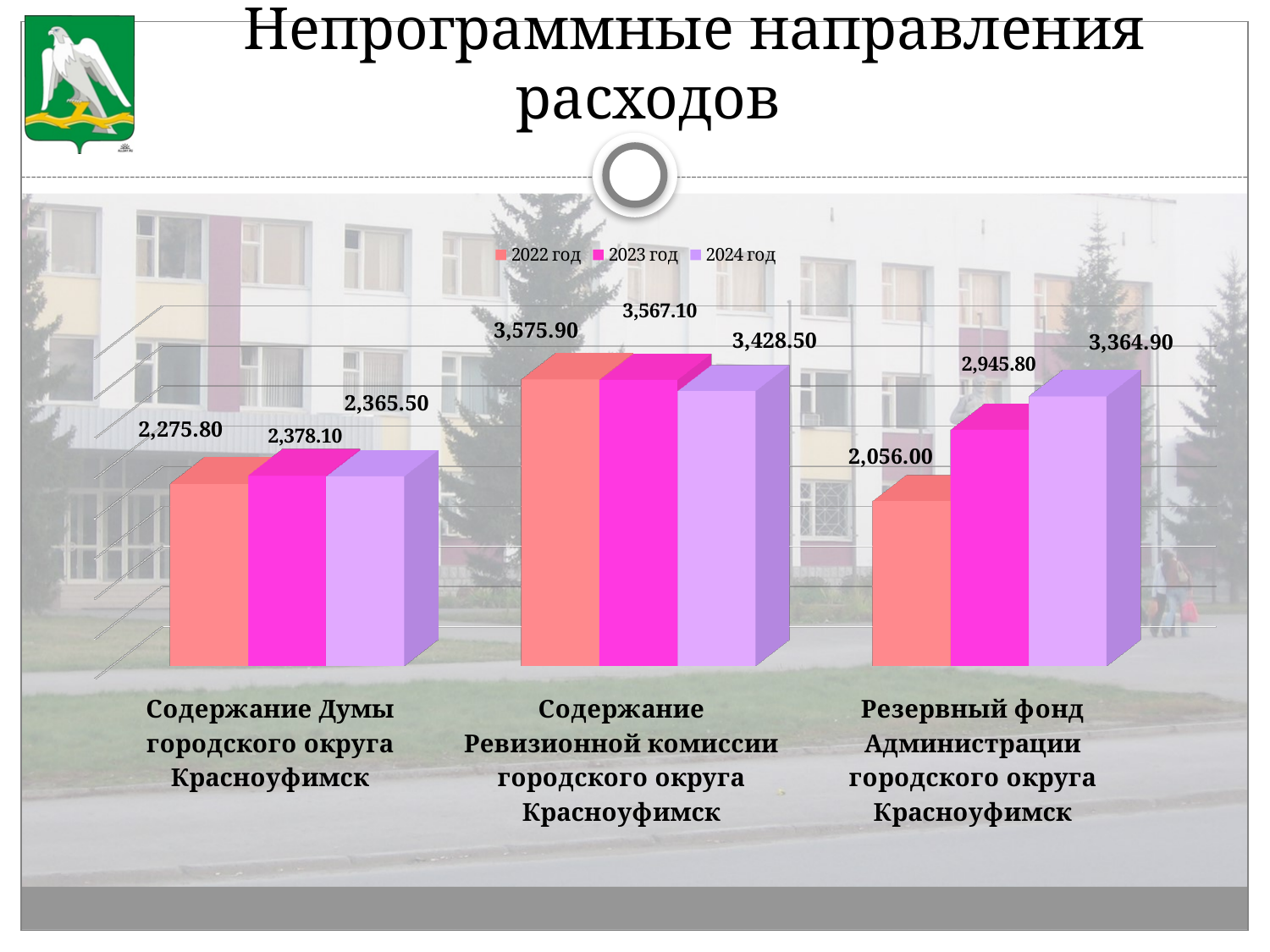
Which category has the lowest value for 2022 год? Резервный фонд Администрации городского округа Красноуфимск How many categories are shown on the x axis? 3 What is the value for 2024 год for Резервный фонд Администрации городского округа Красноуфимск? 3,364.90 Which is larger for Содержание Думы городского округа Красноуфимск: the 2022 год value or the 2023 год value? 2023 год What is the difference between the 2024 год and 2022 год values for Резервный фонд Администрации городского округа Красноуфимск? 1,308.90 What is the value for 2022 год for Содержание Думы городского округа Красноуфимск? 2,275.80 What is the title of the slide? Непрограммные направления расходов How many series does the legend list? 3 For Резервный фонд Администрации городского округа Красноуфимск, do the values rise or fall from 2022 год to 2024 год? Rise What kind of chart is shown on the slide? Bar chart What is the value for 2023 год for Содержание Ревизионной комиссии городского округа Красноуфимск? 3,567.10 Which category has the highest value for 2022 год? Содержание Ревизионной комиссии городского округа Красноуфимск